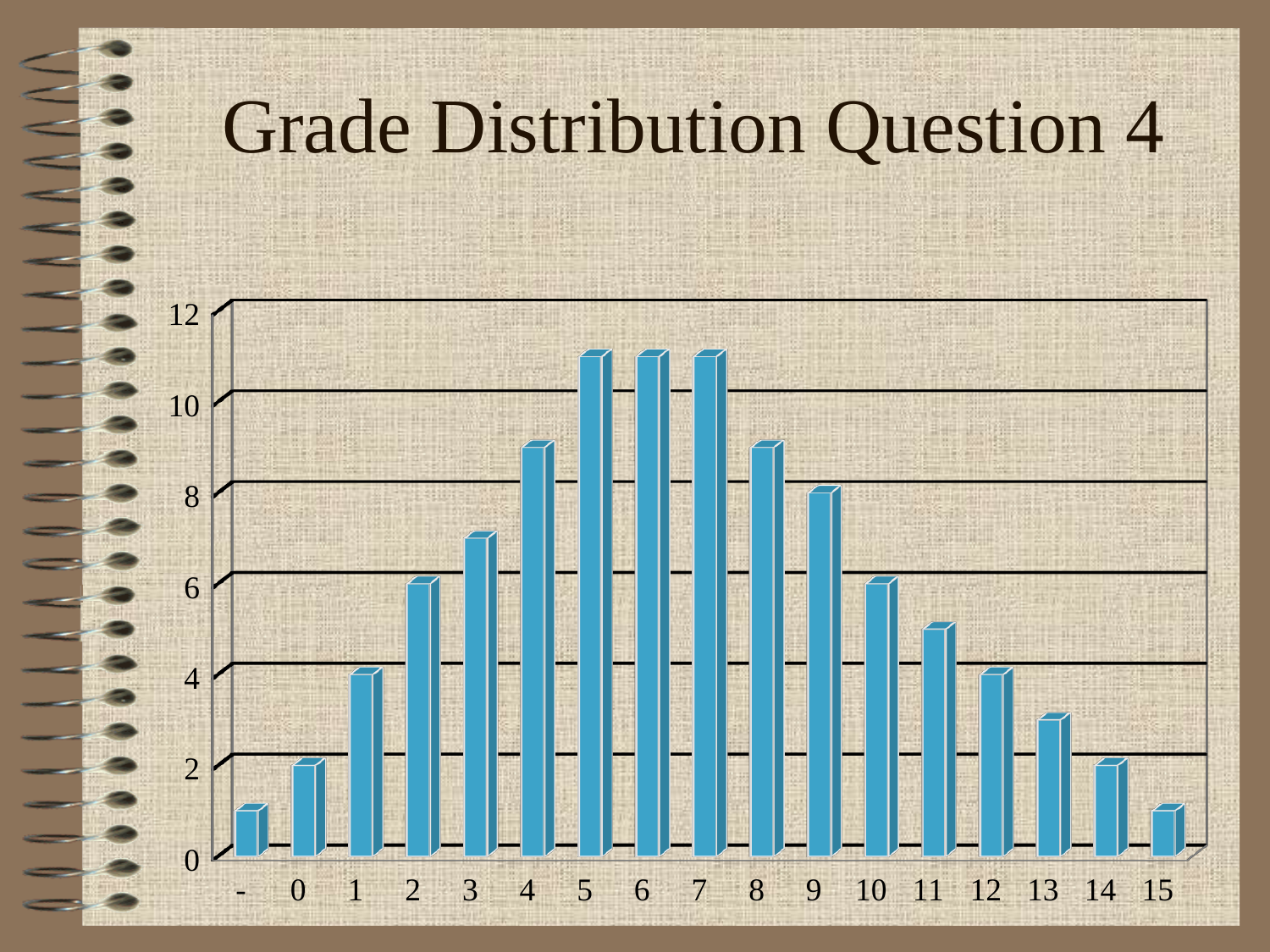
Is the value for category 4 greater or less than 8? greater What is the difference between the values for category 2 and category 14? 4 What is the value for category 2? 6 Is the value for category 13 greater or less than 4? less What is the title of the chart? Grade Distribution Question 4 Do the values rise or fall from category 7 to category 15? fall What type of chart is shown on the slide? bar chart What is the value for category 1? 4 Which is larger, the value for category 3 or the value for category 11? category 3 What is the value for category 14? 2 How many categories are shown on the x axis? 17 Is the value for category 5 greater or less than 10? greater